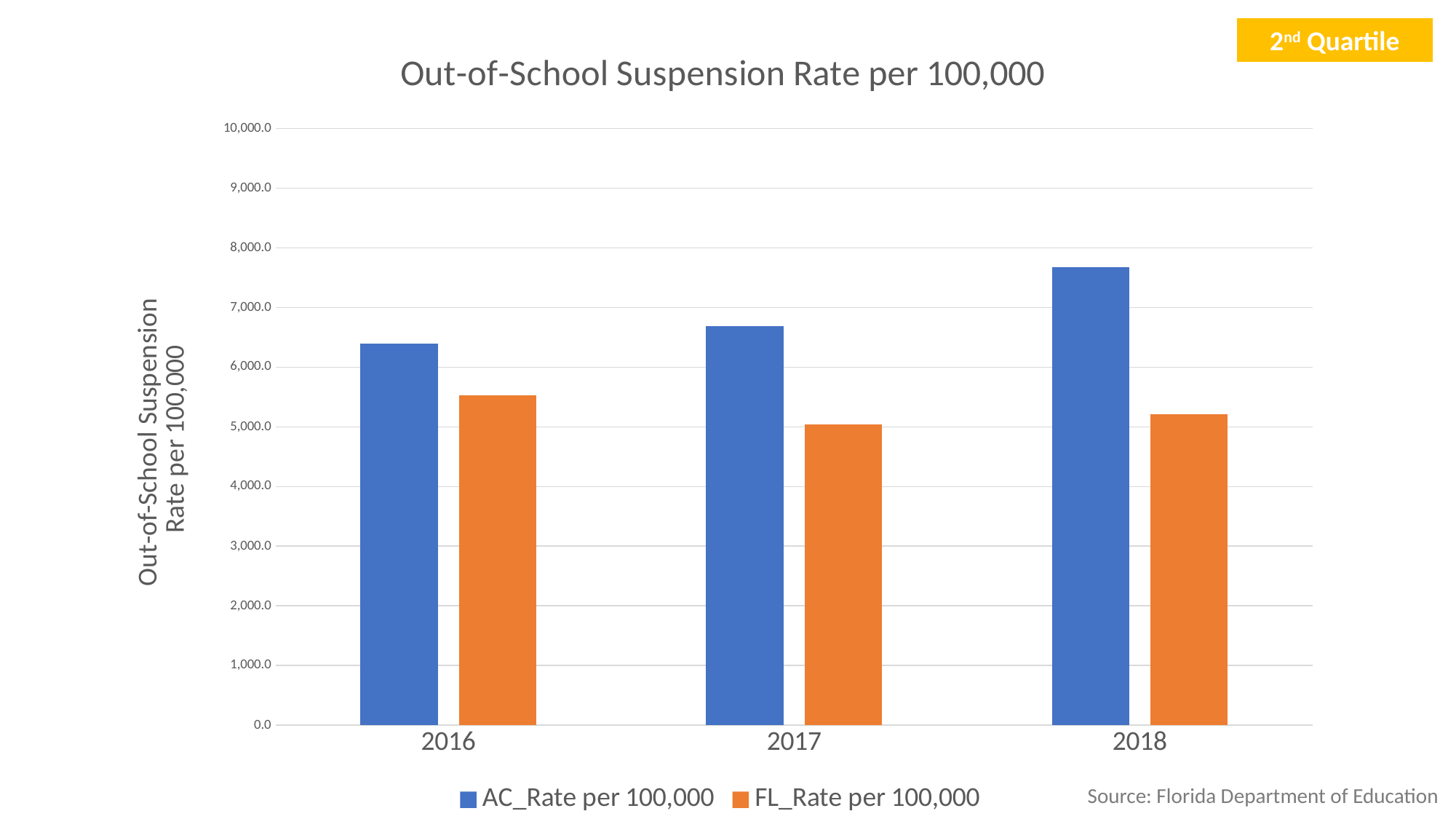
Is the AC_Rate per 100,000 for 2018 greater or less than 7,000? greater In which year is the FL_Rate per 100,000 highest? 2016 How many series does the legend list? 2 How many years are shown on the x axis? 3 Does the AC_Rate per 100,000 rise or fall from 2016 to 2018? rise What type of chart is shown on the slide? bar chart What is the title of the chart? Out-of-School Suspension Rate per 100,000 In which year is the AC_Rate per 100,000 lowest? 2016 In 2018, which is larger: the AC_Rate per 100,000 or the FL_Rate per 100,000? AC_Rate per 100,000 In which year is the AC_Rate per 100,000 highest? 2018 Is the AC_Rate per 100,000 for 2016 greater or less than 6,000? greater Is the FL_Rate per 100,000 for 2017 greater or less than 6,000? less